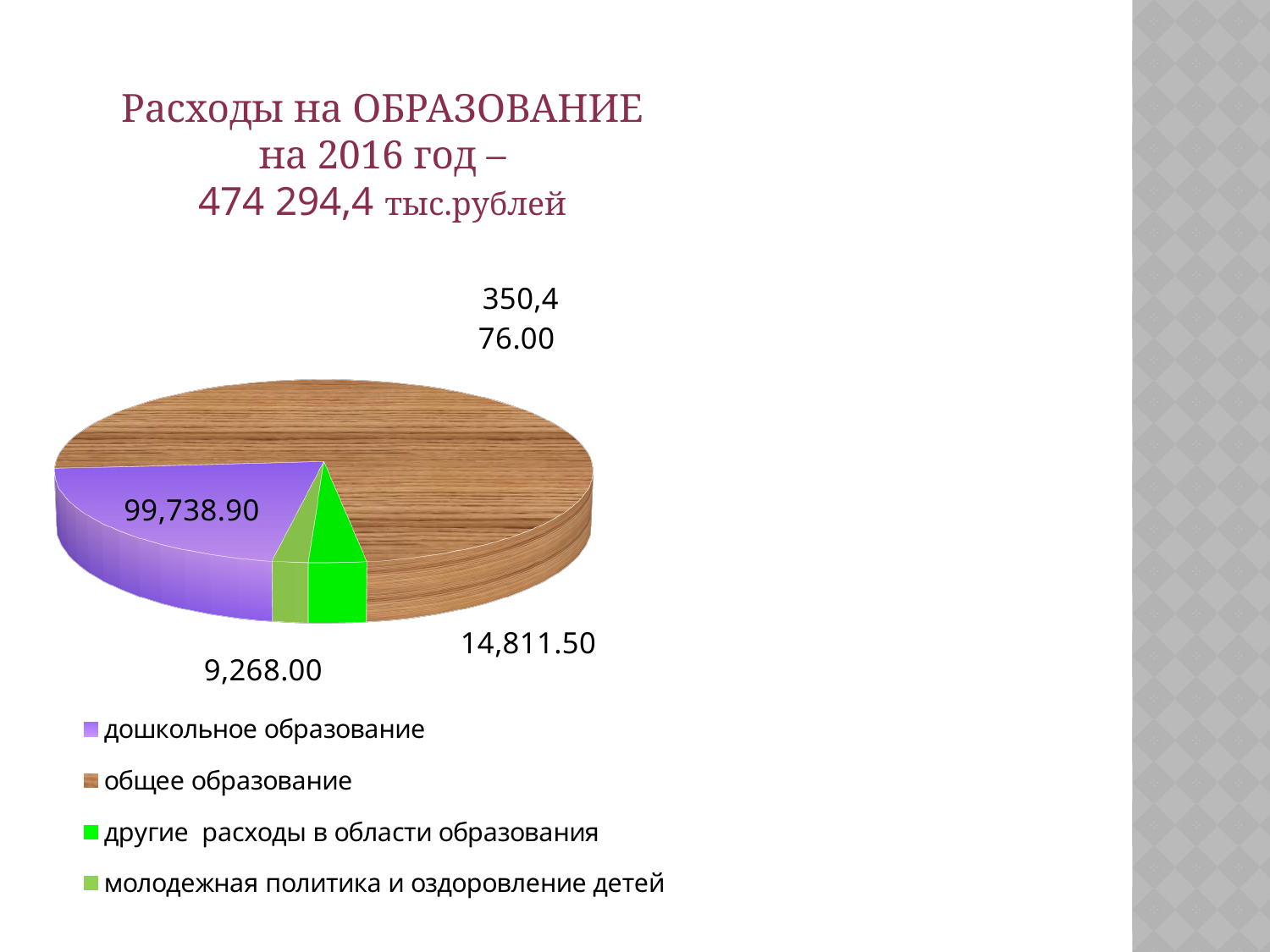
Which category has the largest slice of the pie? общее образование What is the difference between the values for дошкольное образование and другие расходы в области образования? 84,927.40 What is the value for дошкольное образование? 99,738.90 What colour is the slice for дошкольное образование? purple Which is larger: дошкольное образование or другие расходы в области образования? дошкольное образование What is the value for молодежная политика и оздоровление детей? 9,268.00 What is the value for другие расходы в области образования? 14,811.50 According to the slide title, what is the total expenditure on education for 2016? 474 294,4 тыс.рублей What kind of chart is shown on the slide? pie chart Which category has the smallest slice of the pie? молодежная политика и оздоровление детей What is the difference between the values for другие расходы в области образования and молодежная политика и оздоровление детей? 5,543.50 How many slices does the pie chart have? 4